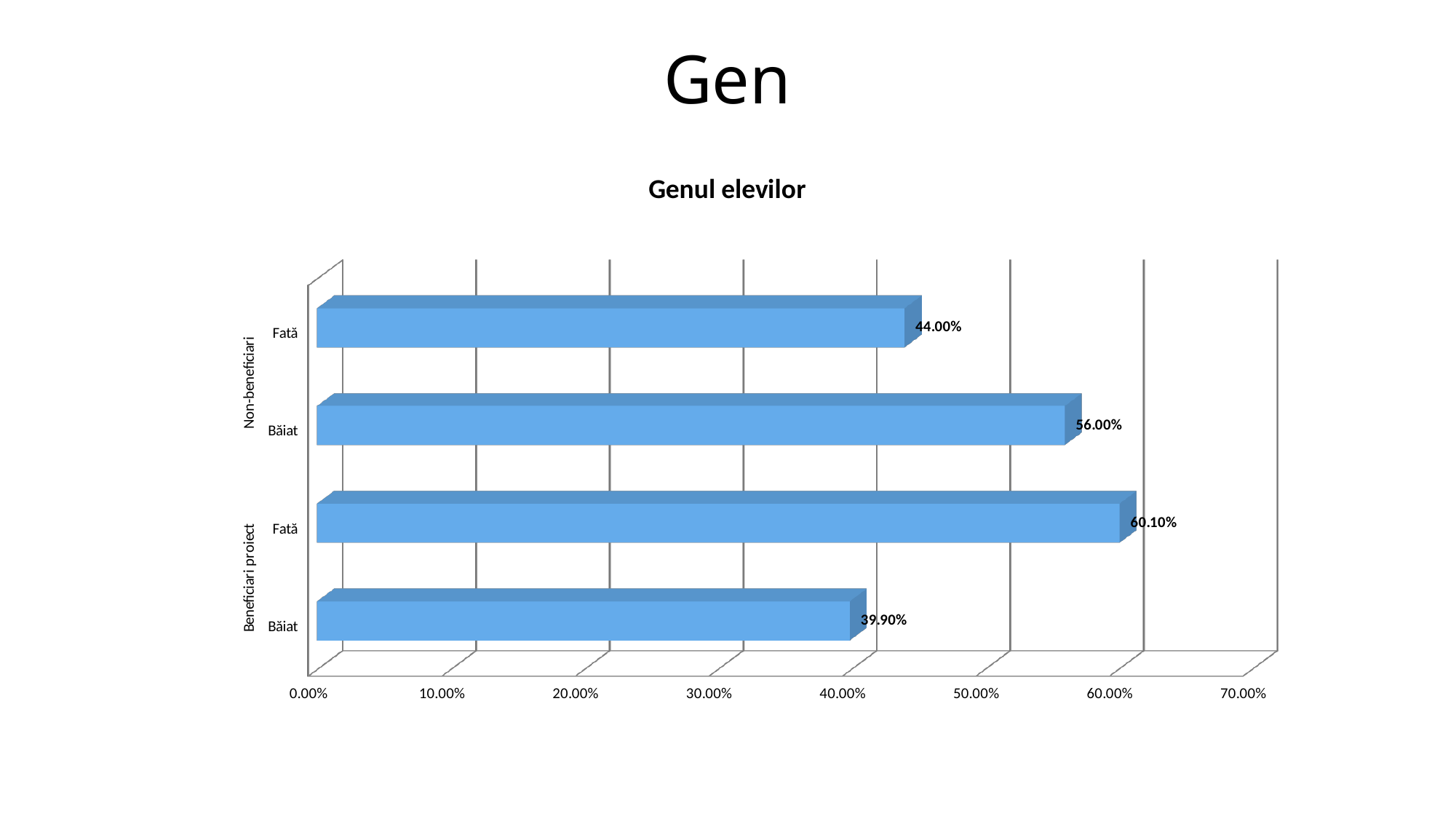
How many bars are plotted in the chart? 4 What is the value for Băiat in the Beneficiari proiect group? 39.90% Which bar has the lowest value? Băiat (Beneficiari proiect) What is the value for Fată in the Non-beneficiari group? 44.00% Which is larger: Fată in Non-beneficiari or Băiat in Beneficiari proiect? Fată in Non-beneficiari What is the title of the chart? Genul elevilor What is the value for Băiat in the Non-beneficiari group? 56.00% What is the value for Fată in the Beneficiari proiect group? 60.10% What kind of chart is shown? Bar chart What is the difference between Băiat and Fată in the Non-beneficiari group? 12.00% Which bar has the highest value? Fată (Beneficiari proiect) What is the difference between Fată and Băiat in the Beneficiari proiect group? 20.20%